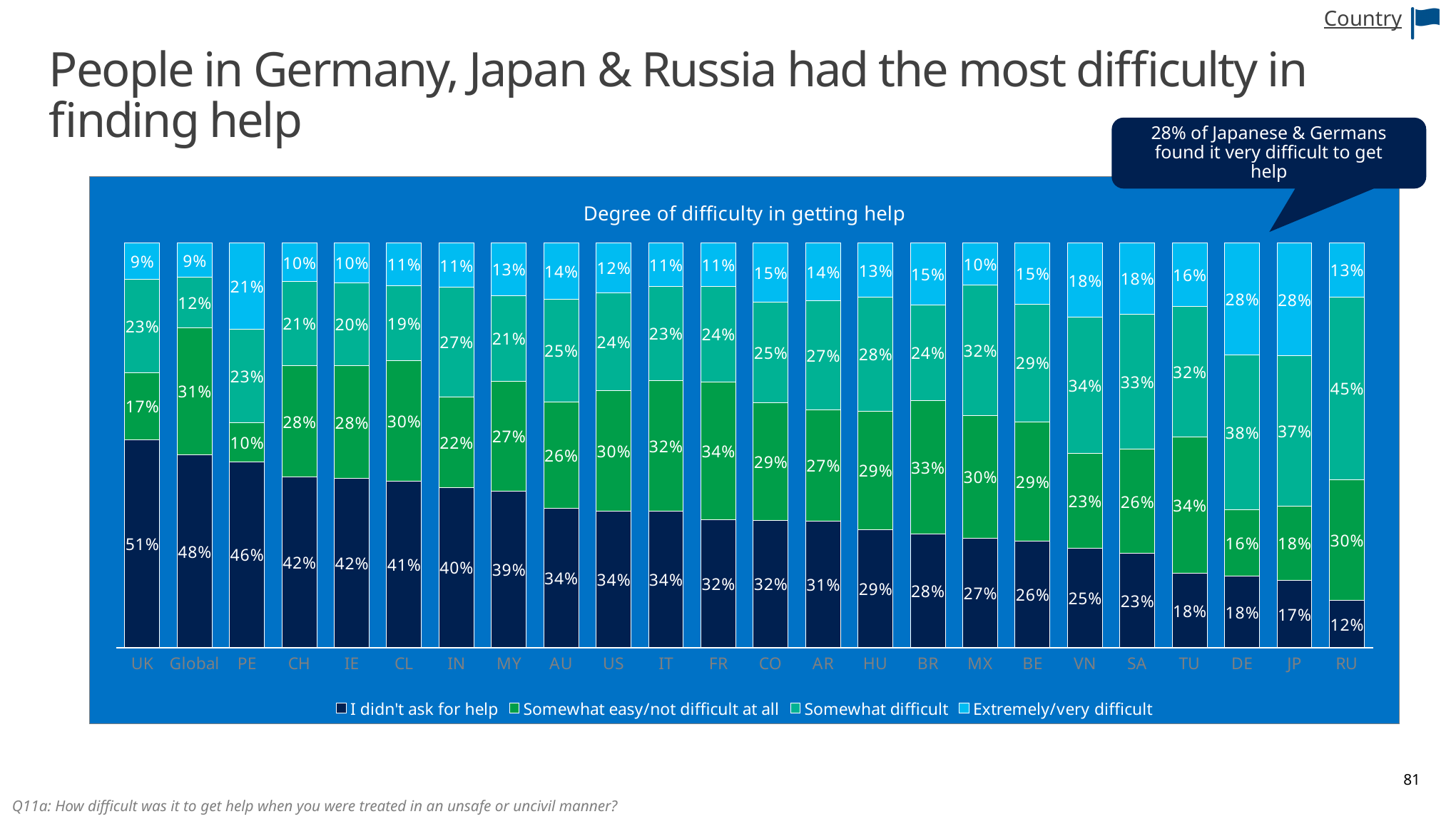
Which country has the lowest 'Somewhat easy/not difficult at all' value? PE Which country has the highest 'I didn't ask for help' value? UK What type of chart is shown on the slide? Stacked bar chart What is the 'Somewhat difficult' value for RU? 45% How many countries/categories are shown along the x axis? 24 Which country has the lowest 'I didn't ask for help' value? RU What is the difference between the 'Extremely/very difficult' values for DE and UK? 19% What is the value for 'I didn't ask for help' for the UK? 51% What is the title of the chart? Degree of difficulty in getting help Which is larger: the 'Somewhat difficult' value for VN or for MX? VN What is the 'Extremely/very difficult' value for PE? 21% How many series does the legend list? 4